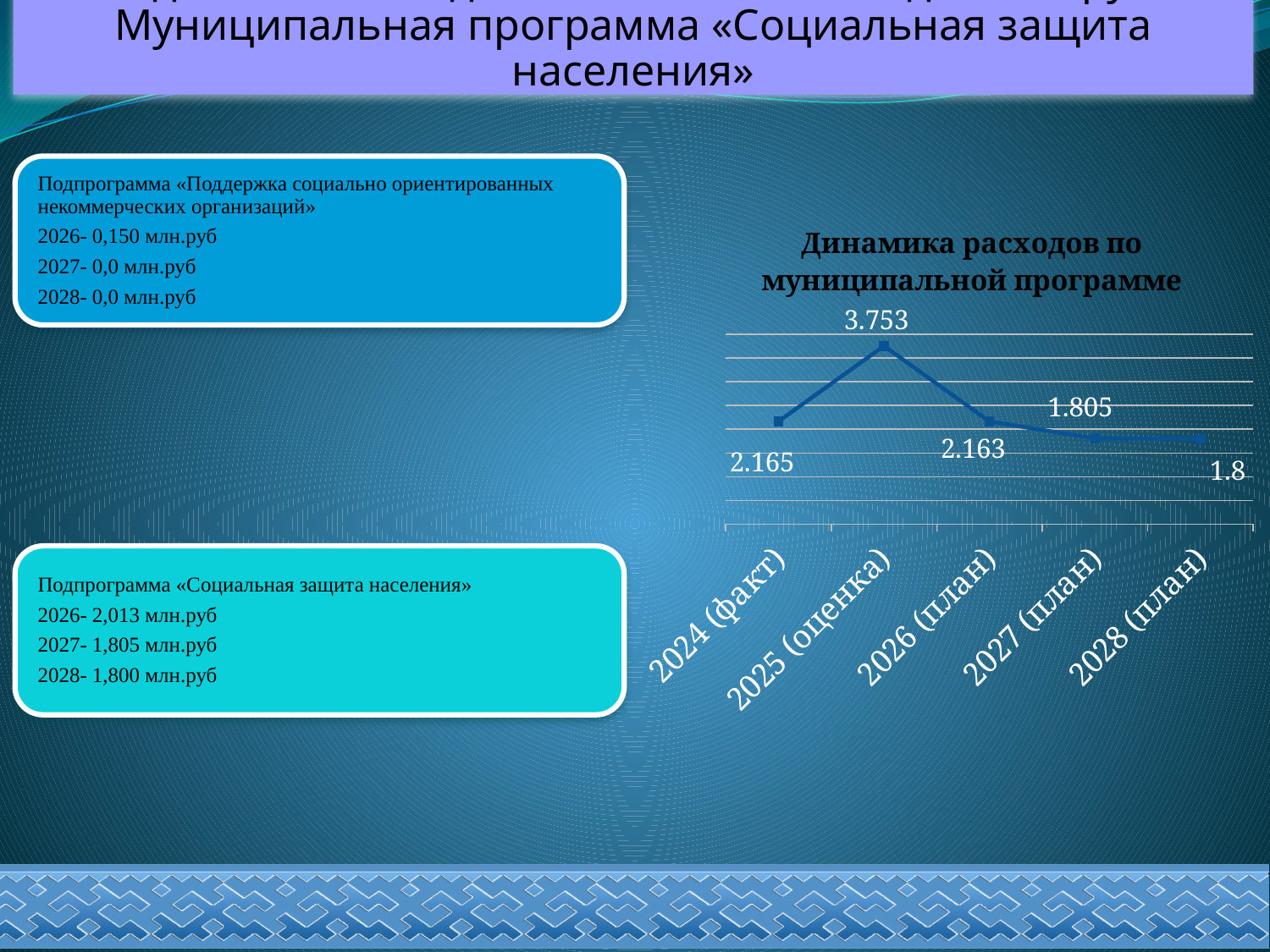
What is the value for 2027 (план) in the chart? 1.805 How many categories are plotted on the x axis of the chart? 5 What is the difference between the values for 2025 (оценка) and 2024 (факт)? 1.588 Which category has the highest value in the chart? 2025 (оценка) Which is larger: the value for 2025 (оценка) or the value for 2027 (план)? 2025 (оценка) From 2025 (оценка) to 2028 (план), do the values rise or fall? Fall What is the value for 2028 (план) in the chart? 1.8 What is the value for 2024 (факт) in the chart «Динамика расходов по муниципальной программе»? 2.165 Which category has the lowest value in the chart? 2028 (план) What is the value for 2025 (оценка) in the chart? 3.753 What is the value for 2026 (план) in the chart? 2.163 What kind of chart is shown on the slide? Line chart